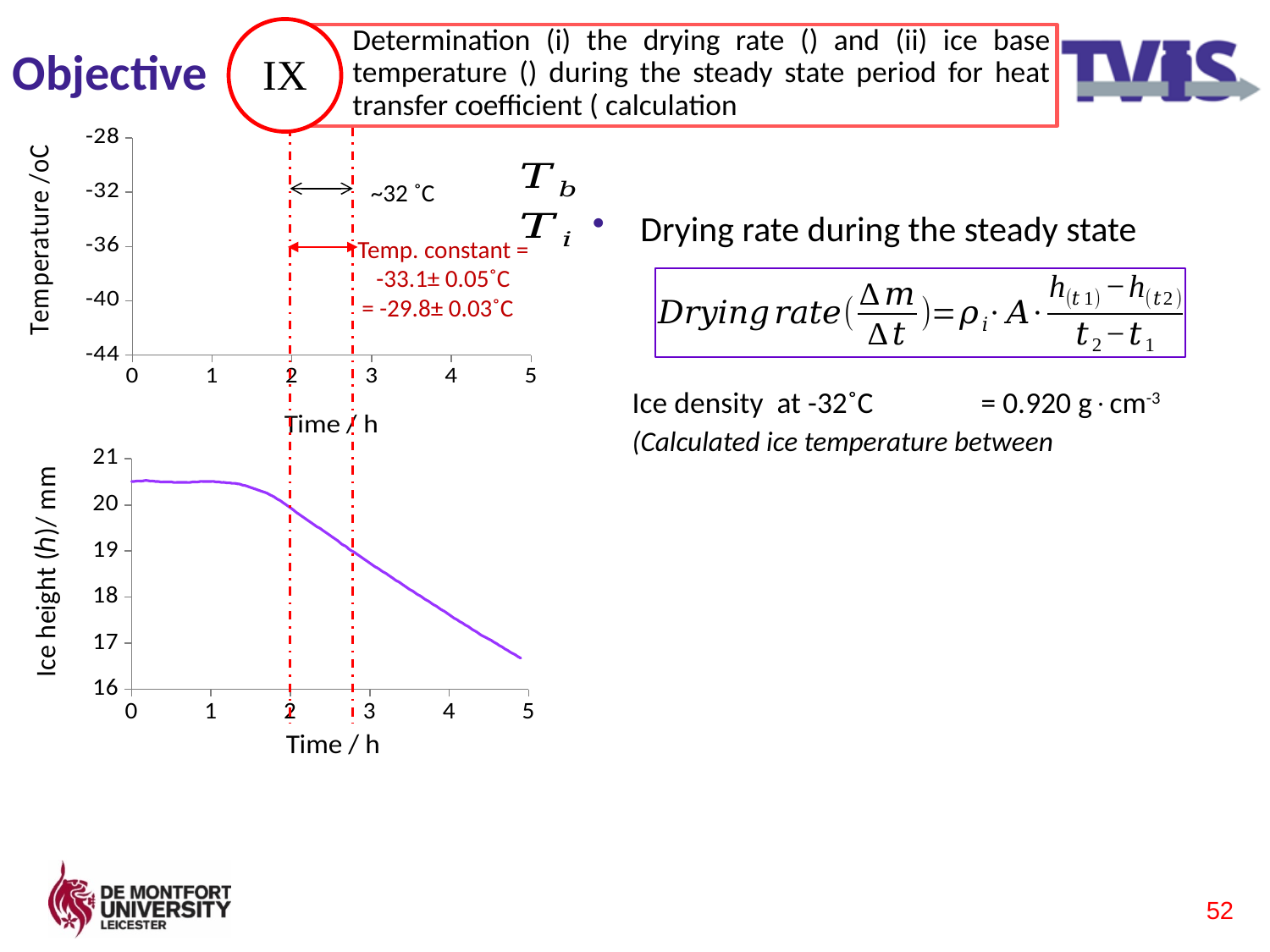
How many tick marks are labelled on the x axis of the bottom chart? 6 What is the y-axis label of the top chart? Temperature /oC In the bottom chart, is the ice height at 1 h larger or smaller than at 4 h? larger In the bottom chart, is the ice height at the end of the curve (near 5 h) greater or less than 17 mm? less In the bottom chart, at roughly which time is the ice height at its lowest: the start (0 h) or the end (near 5 h)? the end (near 5 h) In the bottom chart, does the ice height rise or fall as time increases? fall What is the x-axis label of the bottom chart? Time / h What kind of chart is the bottom chart (Ice height vs Time)? line chart In the bottom chart, is the ice height at 4 h greater or less than 18 mm? less How many data series are plotted in the bottom chart? 1 In the bottom chart, is the ice height at 1 h greater or less than 20 mm? greater